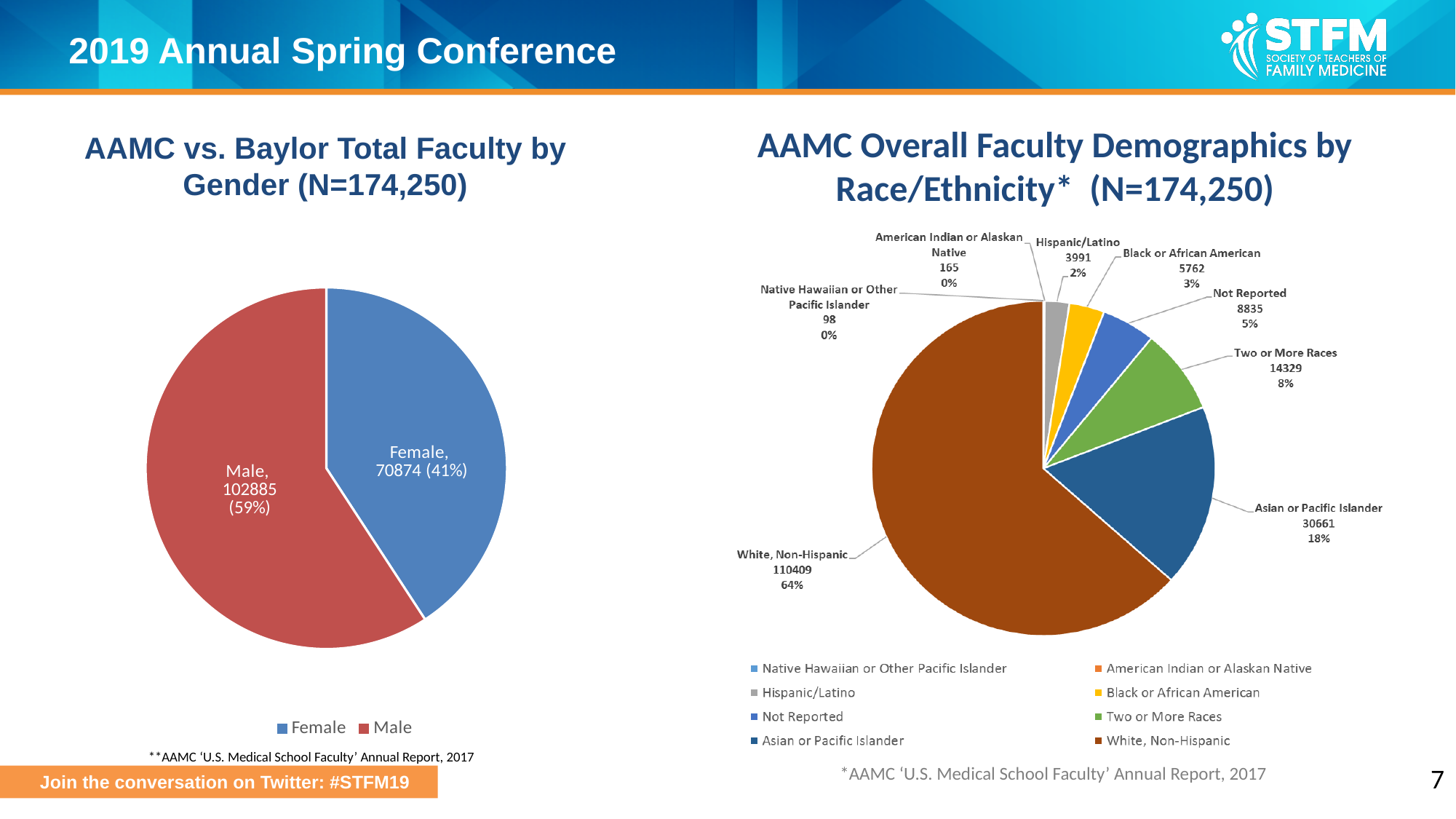
In the 'AAMC vs. Baylor Total Faculty by Gender' chart, what share of the pie is Female? 41% In the 'AAMC Overall Faculty Demographics by Race/Ethnicity' chart, what is the value for Asian or Pacific Islander? 30661 In the 'AAMC Overall Faculty Demographics by Race/Ethnicity' chart, which category is the smallest? Native Hawaiian or Other Pacific Islander How many entries does the legend of the 'AAMC Overall Faculty Demographics by Race/Ethnicity' chart list? 8 In the 'AAMC vs. Baylor Total Faculty by Gender' chart, what is the difference between the Male and Female values? 32011 What kind of chart is the 'AAMC vs. Baylor Total Faculty by Gender' chart? Pie chart In the 'AAMC vs. Baylor Total Faculty by Gender' chart, what is the value for Male? 102885 How many categories does the 'AAMC vs. Baylor Total Faculty by Gender' chart show? 2 In the 'AAMC Overall Faculty Demographics by Race/Ethnicity' chart, what is the difference between Hispanic/Latino and American Indian or Alaskan Native? 3826 In the 'AAMC Overall Faculty Demographics by Race/Ethnicity' chart, what share of the pie is Two or More Races? 8% In the 'AAMC Overall Faculty Demographics by Race/Ethnicity' chart, which is larger: Not Reported or Black or African American? Not Reported In the 'AAMC Overall Faculty Demographics by Race/Ethnicity' chart, which category is the largest? White, Non-Hispanic